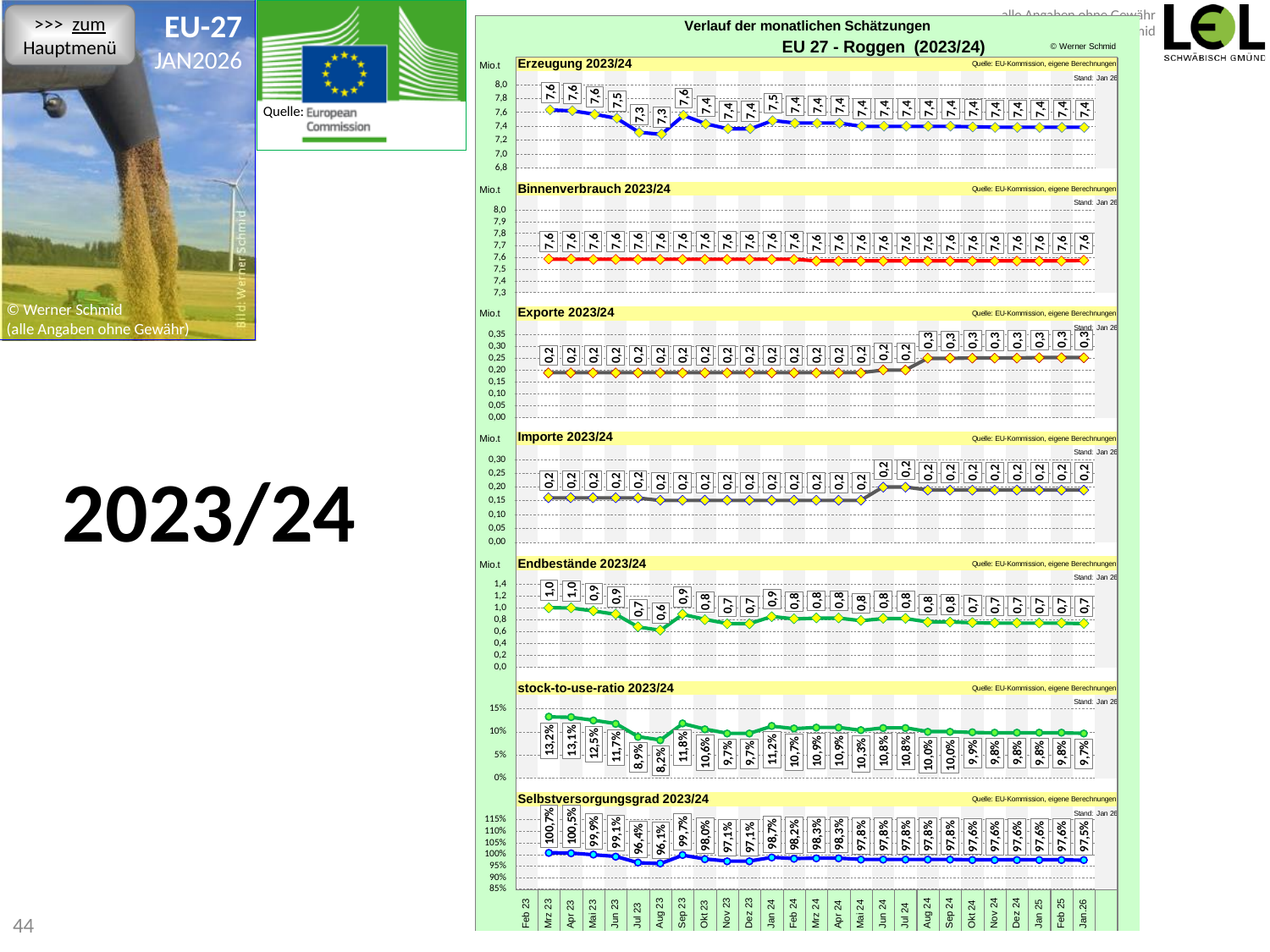
In the 'Selbstversorgungsgrad 2023/24' chart, what is the value of the last point (Jan 26)? 97,5% What kind of chart is used for the 'Erzeugung 2023/24' panel? line chart In the 'Endbestände 2023/24' chart, what is the lowest value shown? 0,6 In the 'Endbestände 2023/24' chart, what is the highest value shown? 1,0 In the 'Binnenverbrauch 2023/24' chart, do the values rise, fall or stay constant across the months? stay constant In the 'stock-to-use-ratio 2023/24' chart, what is the lowest value shown? 8,2% In the 'Exporte 2023/24' chart, what is the value of the last point (Jan 26)? 0,3 In the 'Erzeugung 2023/24' chart, what is the value of the last point (Jan 26)? 7,4 In the 'Erzeugung 2023/24' chart, what is the lowest value shown? 7,3 What is the overall title shown above the set of charts, naming the region and commodity? EU 27 - Roggen (2023/24) Which is larger for the last point (Jan 26): the value in the 'Erzeugung 2023/24' chart or the value in the 'Binnenverbrauch 2023/24' chart? Binnenverbrauch 2023/24 In the 'stock-to-use-ratio 2023/24' chart, what is the highest value shown? 13,2%